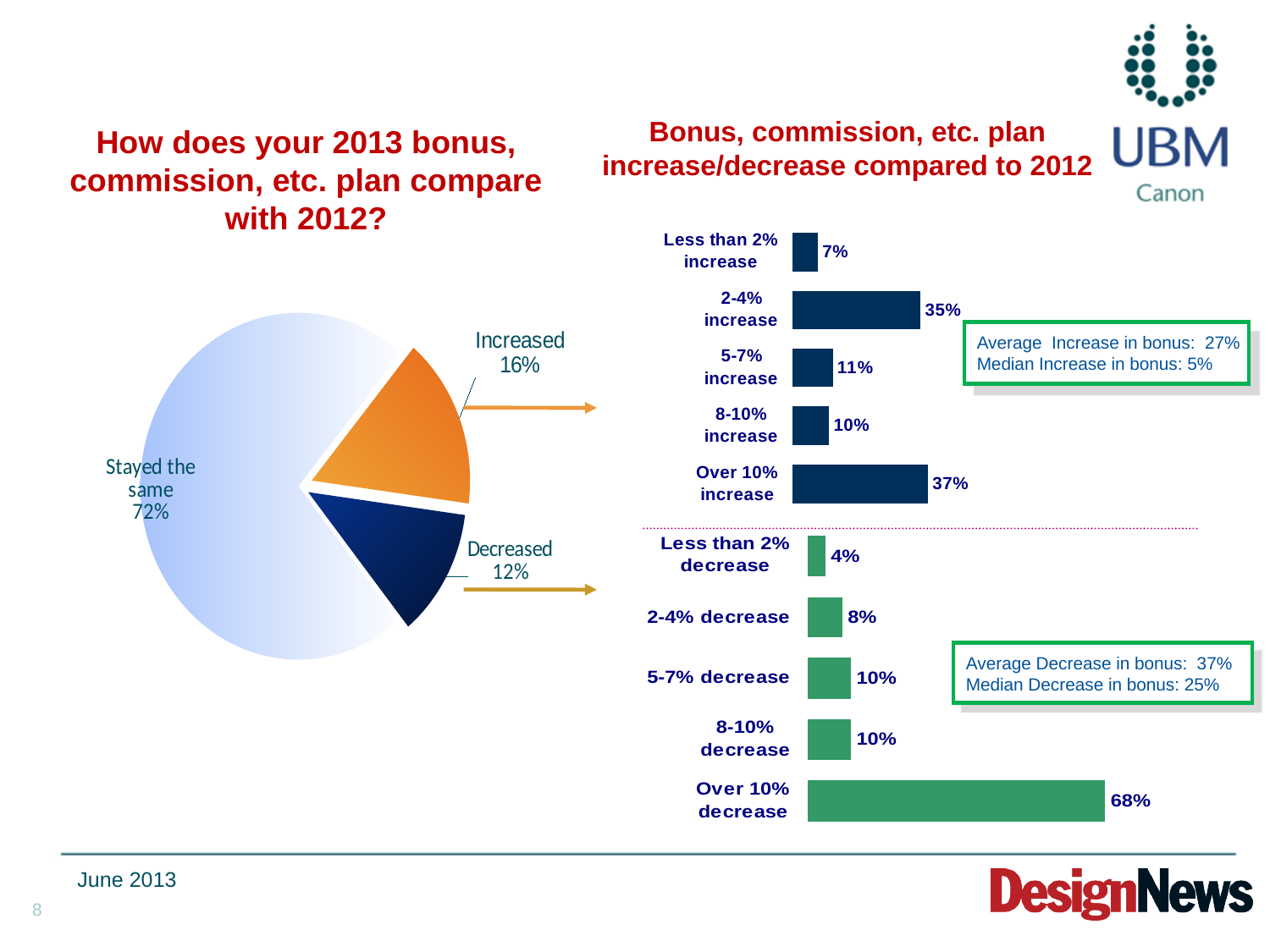
In the pie chart on the left, what share of respondents said their bonus plan stayed the same? 72% In the pie chart on the left, which category has the smallest slice? Decreased In the pie chart on the left, what percentage of respondents said their bonus plan increased? 16% In the pie chart on the left, what is the difference between the Increased and Decreased shares? 4% In the decrease bar chart on the right (green bars), what is the difference between 'Over 10% decrease' and '2-4% decrease'? 60% In the increase bar chart on the right (dark blue bars), which category has the lowest value? Less than 2% increase In the increase bar chart on the right (dark blue bars), what is the value for '2-4% increase'? 35% In the decrease bar chart on the right (green bars), what is the value for 'Over 10% decrease'? 68% What type of chart is used for the 'Bonus, commission, etc. plan increase/decrease compared to 2012' data on the right? Bar chart In the decrease bar chart on the right (green bars), which is larger: 'Less than 2% decrease' or '5-7% decrease'? 5-7% decrease In the increase bar chart on the right (dark blue bars), which category has the highest value? Over 10% increase In the pie chart on the left, how many slices are there? 3